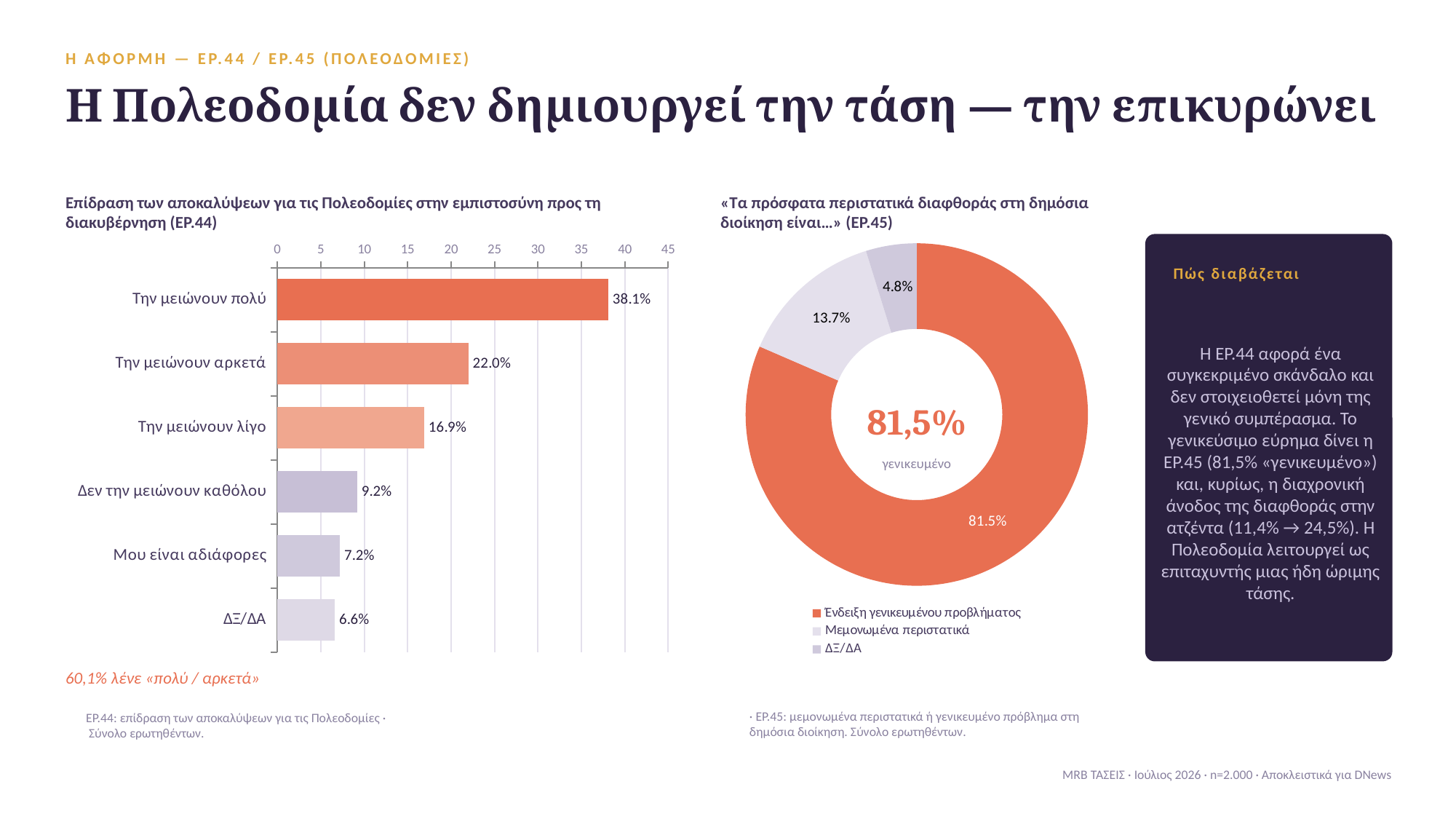
In the bar chart on the left (ΕΡ.44), what is the value for «Δεν την μειώνουν καθόλου»? 9.2% In the bar chart on the left (ΕΡ.44), what is the value for «Την μειώνουν πολύ»? 38.1% In the donut chart on the right (ΕΡ.45), what is the value for «Μεμονωμένα περιστατικά»? 13.7% In the bar chart on the left (ΕΡ.44), which category has the highest value? Την μειώνουν πολύ In the bar chart on the left (ΕΡ.44), which is larger: «Μου είναι αδιάφορες» or «ΔΞ/ΔΑ»? Μου είναι αδιάφορες In the bar chart on the left (ΕΡ.44), how many categories are shown? 6 In the bar chart on the left (ΕΡ.44), what is the difference between «Την μειώνουν πολύ» and «Την μειώνουν αρκετά»? 16.1 percentage points In the donut chart on the right (ΕΡ.45), how many entries does the legend list? 3 In the donut chart on the right (ΕΡ.45), what share is «Ένδειξη γενικευμένου προβλήματος»? 81.5% In the bar chart on the left (ΕΡ.44), which category has the lowest value? ΔΞ/ΔΑ What kind of chart is the chart on the left (ΕΡ.44)? Bar chart In the donut chart on the right (ΕΡ.45), which slice is the smallest? ΔΞ/ΔΑ